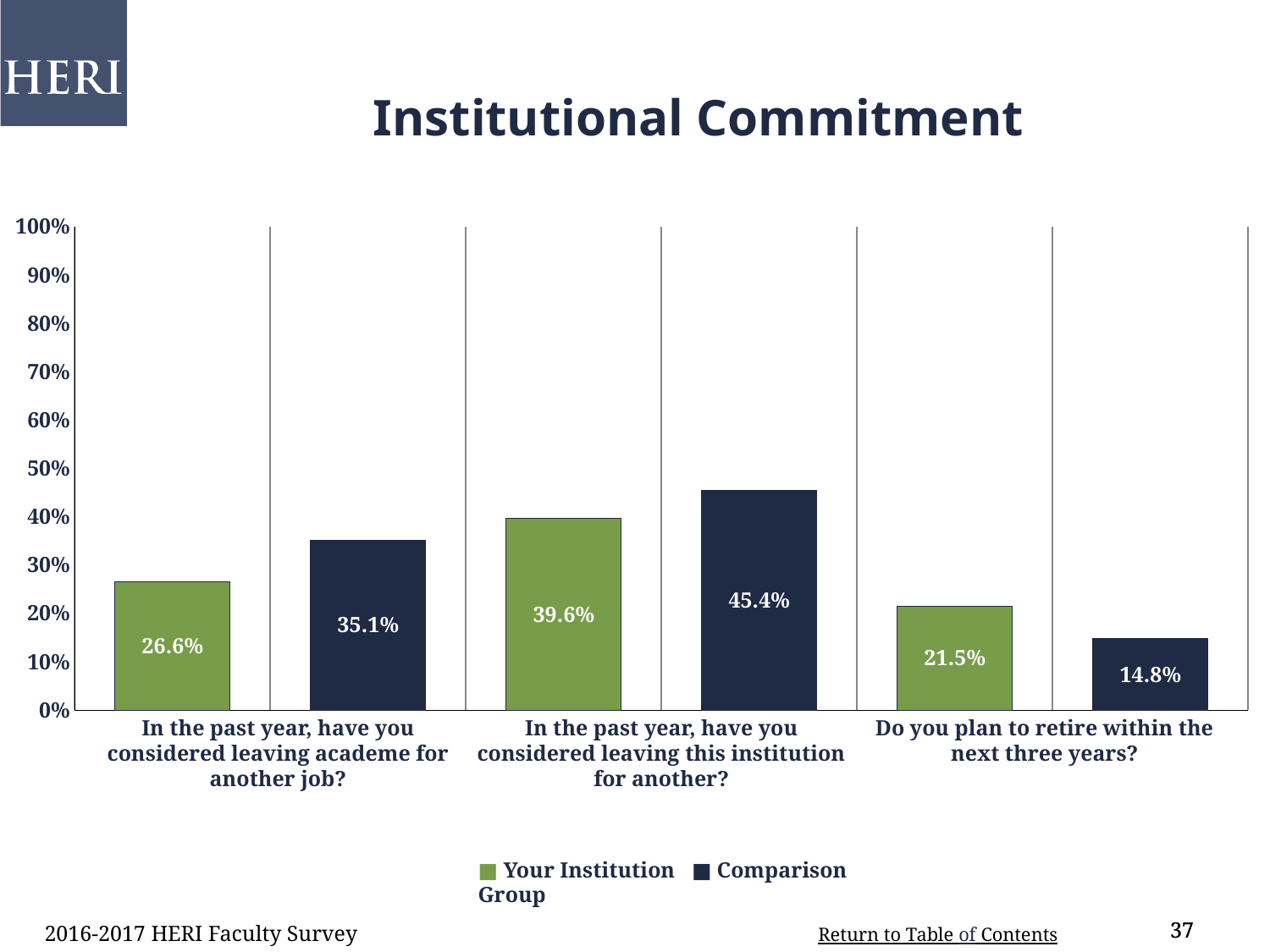
Which question has the lowest Your Institution value? Do you plan to retire within the next three years? Is the Comparison Group value for "In the past year, have you considered leaving this institution for another?" greater or less than 50%? less What kind of chart is shown on the slide? bar chart What is the value for Your Institution on "Do you plan to retire within the next three years?" 21.5% What is the title of the chart? Institutional Commitment What is the difference between the Comparison Group and Your Institution values for "In the past year, have you considered leaving academe for another job?" 8.5% How many series does the legend list? 2 What is the value for Your Institution on "In the past year, have you considered leaving academe for another job?" 26.6% What is the value for Comparison Group on "In the past year, have you considered leaving this institution for another?" 45.4% For "Do you plan to retire within the next three years?", which is larger: Your Institution or Comparison Group? Your Institution How many questions (categories) are shown on the x axis? 3 Which question has the highest Comparison Group value? In the past year, have you considered leaving this institution for another?